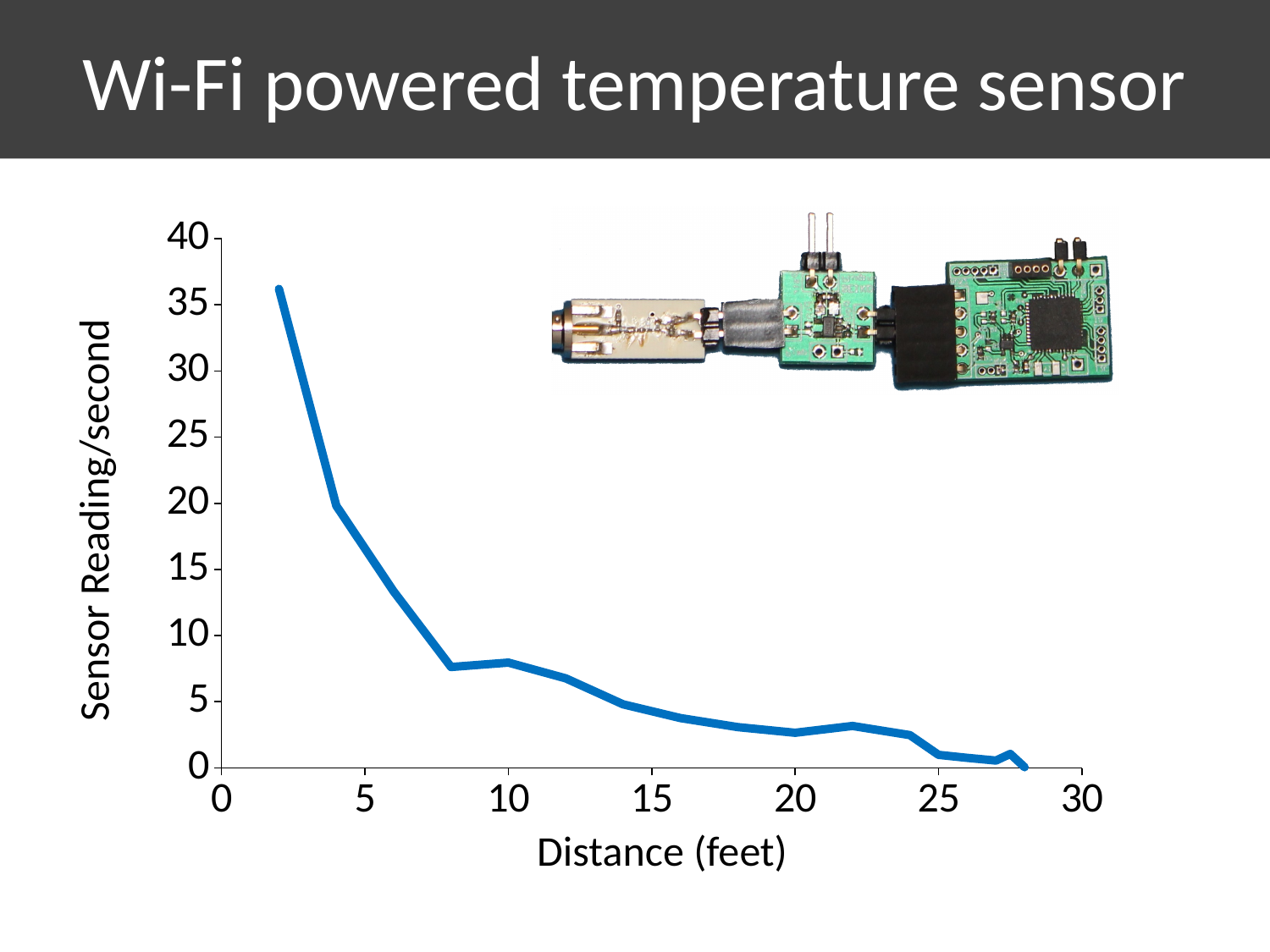
What is the label of the y axis? Sensor Reading/second Which has the higher sensor reading, 4 feet or 8 feet? 4 feet What is the label of the x axis? Distance (feet) Is the sensor reading at 2 feet greater or less than 30? greater What kind of chart is shown on the slide? line chart Is the sensor reading at 20 feet greater or less than 5? less Does the sensor reading rise or fall as distance increases? fall Is the sensor reading at 4 feet greater or less than 25? less Which has the higher sensor reading, 10 feet or 20 feet? 10 feet At which distance is the sensor reading highest? 2 feet